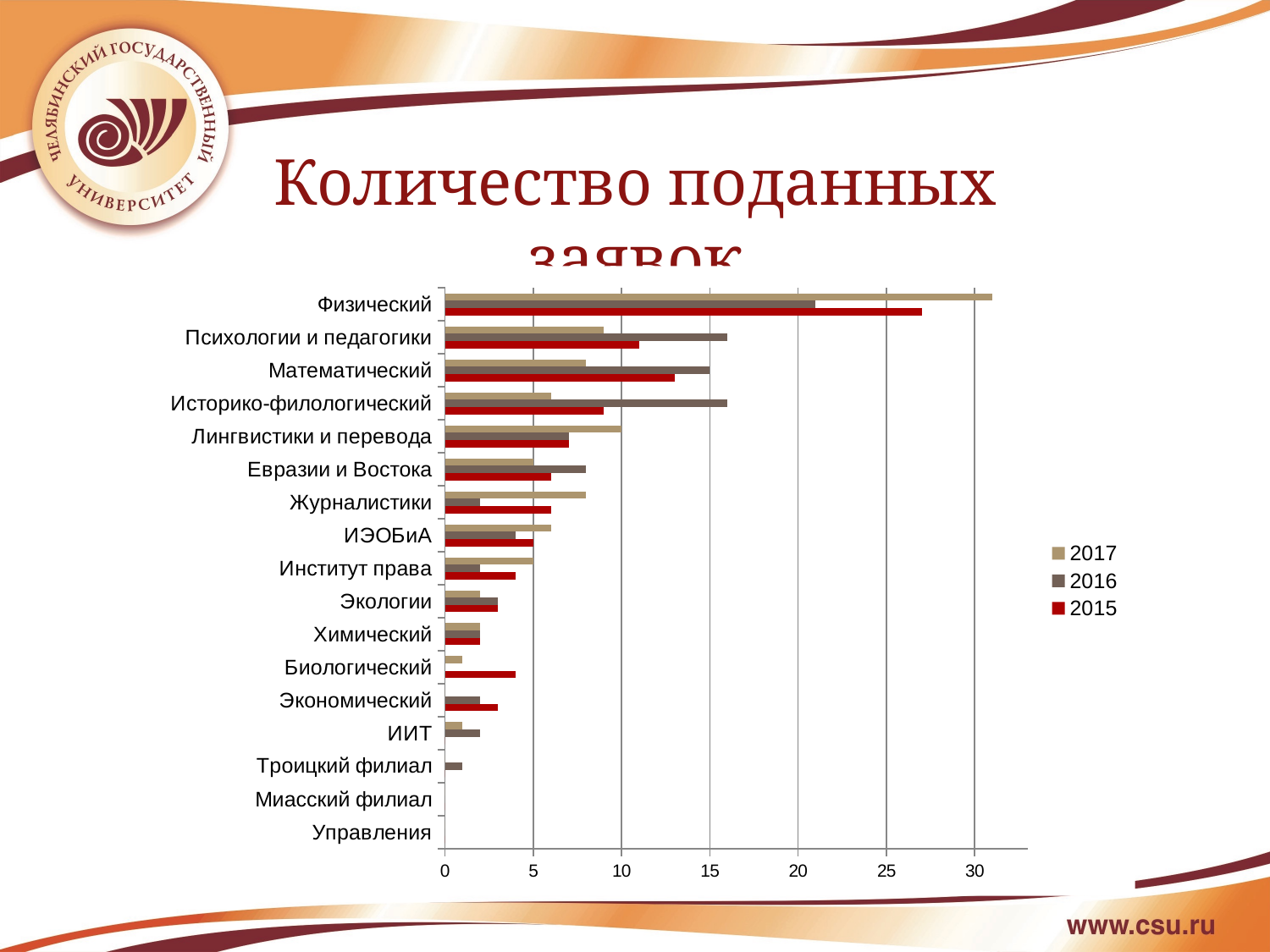
Is the 2016 value for Психологии и педагогики greater or less than 10? greater Is the 2017 value for Физический greater or less than 25? greater What kind of chart is shown on the slide? bar chart For Историко-филологический, which is larger: the 2016 value or the 2017 value? 2016 Is the 2015 value for Физический greater or less than 25? greater Which category has the highest value for 2017? Физический What are the entries listed in the legend? 2017, 2016, 2015 How many categories are shown on the vertical axis of the chart? 17 For Физический, which is larger: the 2015 value or the 2016 value? 2015 Which series has the highest value for Журналистики? 2017 How many series does the legend list? 3